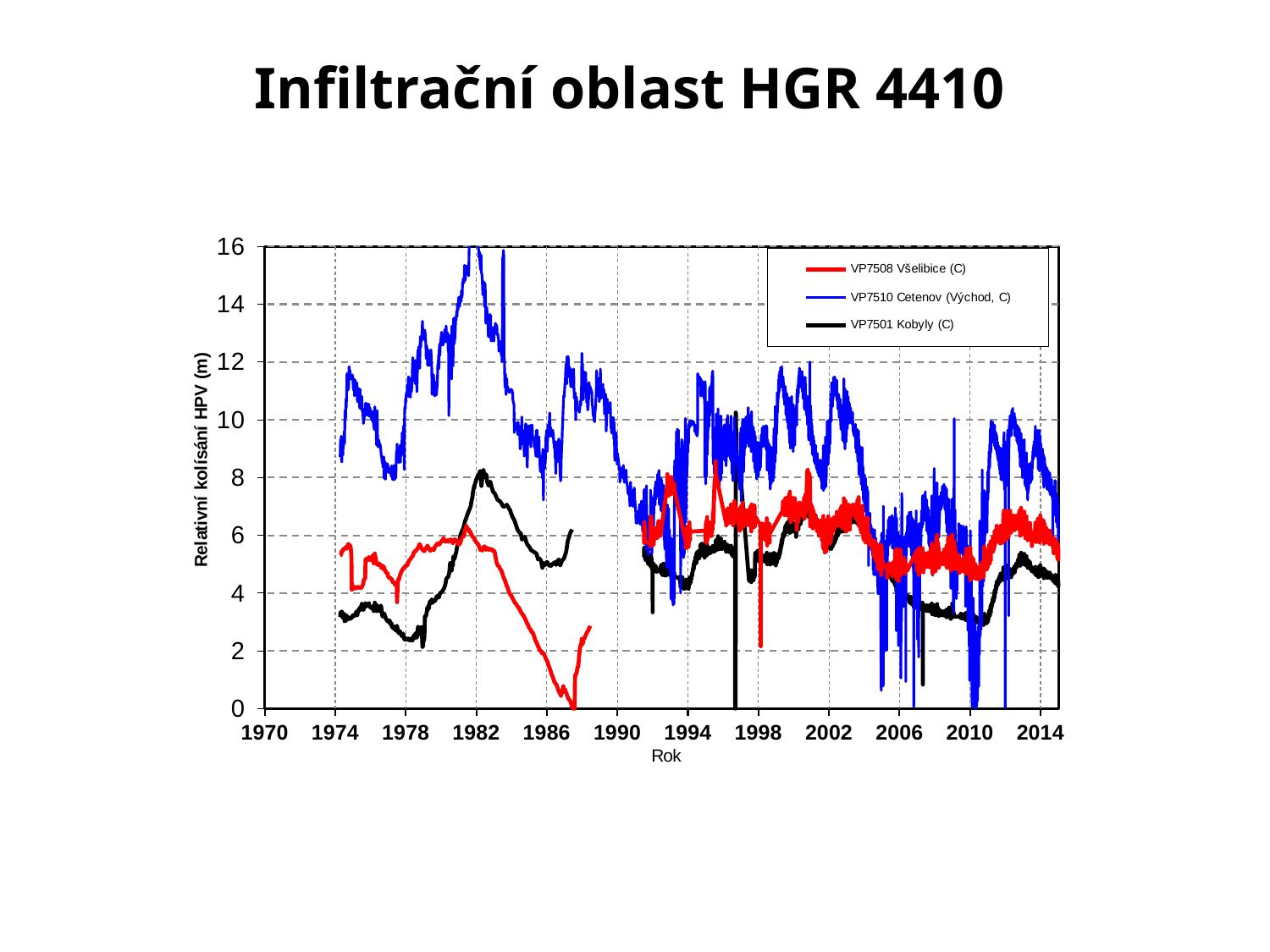
Is the value for VP7501 Kobyly (C) around 1982 greater or less than 10? less Around 1982, which series has the larger value: VP7510 Cetenov (Východ, C) or VP7501 Kobyly (C)? VP7510 Cetenov (Východ, C) Is the value for VP7510 Cetenov (Východ, C) around 1982 greater or less than 12? greater Around 2008, which series has the larger value: VP7508 Všelibice (C) or VP7501 Kobyly (C)? VP7508 Všelibice (C) What kind of chart is shown on the slide? line chart Which series reaches the highest value on the chart? VP7510 Cetenov (Východ, C) Is the value for VP7508 Všelibice (C) around 1987 greater or less than 2? less Does the value for VP7508 Všelibice (C) rise or fall between 1982 and 1987? fall What is the label of the vertical axis? Relativní kolísání HPV (m) Does the value for VP7510 Cetenov (Východ, C) rise or fall between 1978 and 1982? rise How many series does the legend list? 3 Which series is drawn in red? VP7508 Všelibice (C)